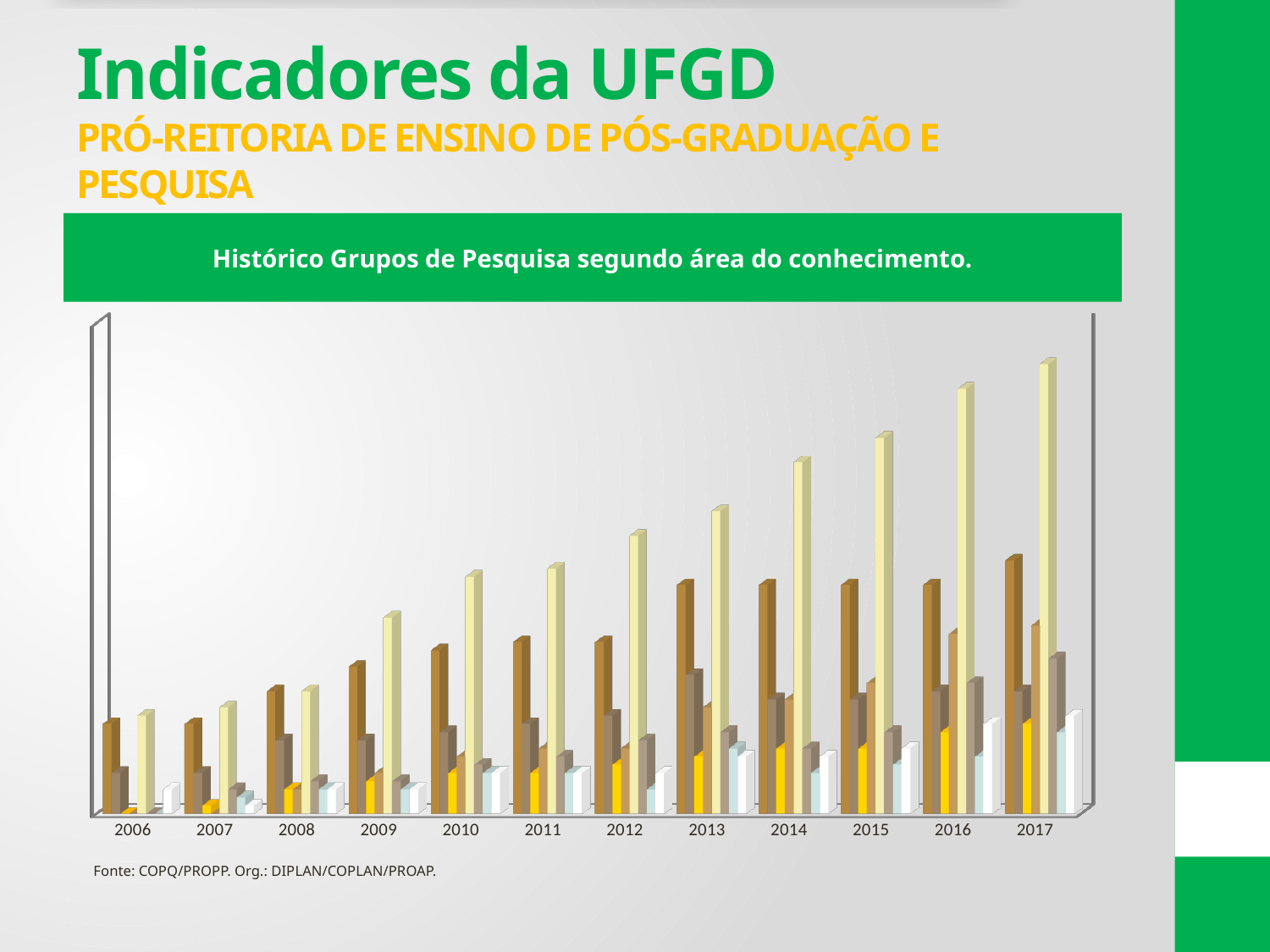
In which year is the dark brown bar the tallest? 2017 Do the pale yellow bars rise or fall from 2006 to 2017? Rise What is the first year shown on the x axis of the chart? 2006 Which year has the taller pale yellow bar, 2016 or 2017? 2017 How many years are shown along the x axis of the chart? 12 Which year has the taller pale yellow bar, 2009 or 2012? 2012 Which year has the taller dark brown bar, 2006 or 2017? 2017 What kind of chart is shown on the slide? Bar chart In which year is the pale yellow bar the shortest? 2006 What is the last year shown on the x axis of the chart? 2017 In which year is the bright yellow bar the shortest? 2006 In which year is the pale yellow bar the tallest? 2017